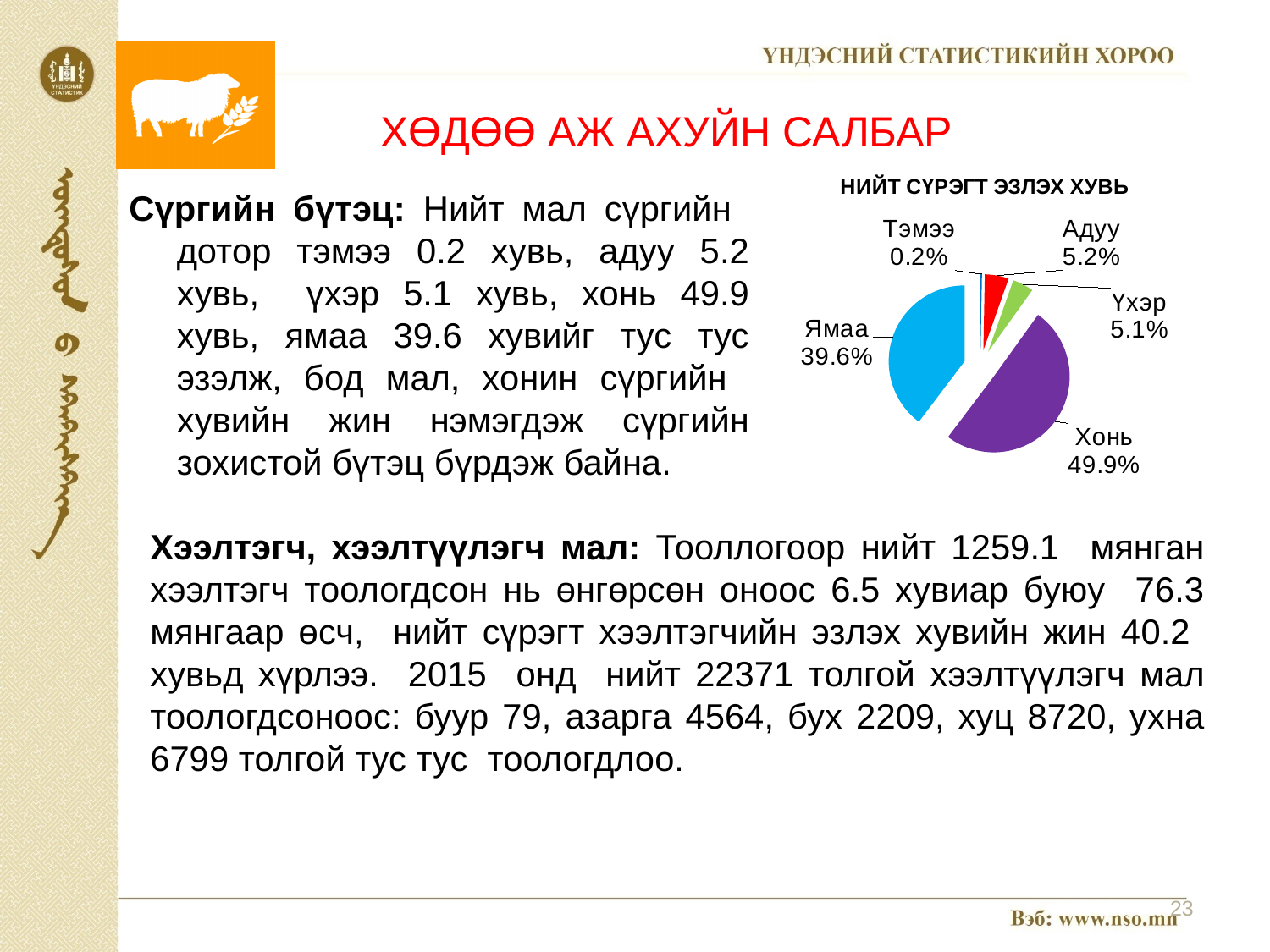
Which category has the smallest slice in the pie chart? Тэмээ What percentage is shown for Тэмээ in the pie chart? 0.2% How many categories are shown in the pie chart? 5 What type of chart is shown on the slide? Pie chart What is the difference in percentage points between Хонь and Ямаа in the pie chart? 10.3 percentage points What is the value shown for Ямаа in the pie chart? 39.6% Which category has the largest slice in the pie chart? Хонь What is the title of the pie chart? НИЙТ СҮРЭГТ ЭЗЛЭХ ХУВЬ What is the value for Адуу in the pie chart? 5.2% What share of the total herd does Хонь account for in the pie chart? 49.9% Which is larger in the pie chart, Хонь or Ямаа? Хонь What is the value for Үхэр in the pie chart? 5.1%